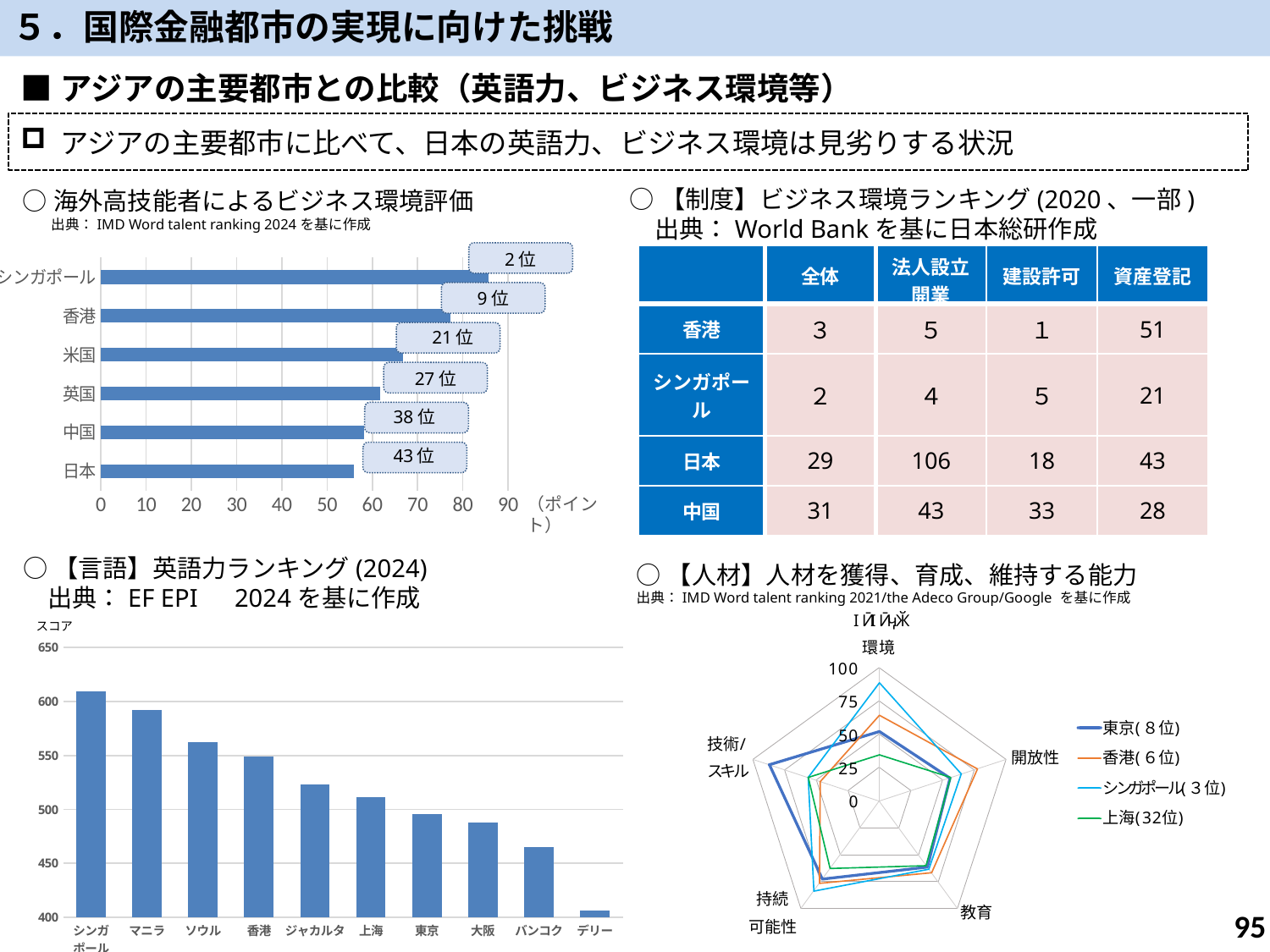
In the top-left chart (海外高技能者によるビジネス環境評価), which category has the longest bar? シンガポール What kind of chart is the bottom-left chart (英語力ランキング 2024)? Bar chart In the top-left chart (海外高技能者によるビジネス環境評価), what rank label is shown for 日本? 43位 In the bottom-right radar chart (人材を獲得、育成、維持する能力), what rank is shown in the legend entry for 上海? 32位 In the top-left chart (海外高技能者によるビジネス環境評価), what rank label is shown for シンガポール? 2位 In the bottom-left chart (英語力ランキング 2024), do the values rise or fall from left to right along the x axis? fall In the top-left chart (海外高技能者によるビジネス環境評価), is the value for 日本 greater or less than 60? less In the bottom-left chart (英語力ランキング 2024), which city has the lowest score? デリー How many series does the legend of the bottom-right radar chart (人材を獲得、育成、維持する能力) list? 4 In the top-left chart (海外高技能者によるビジネス環境評価), how many categories are plotted? 6 In the bottom-left chart (英語力ランキング 2024), which city has the highest score? シンガポール